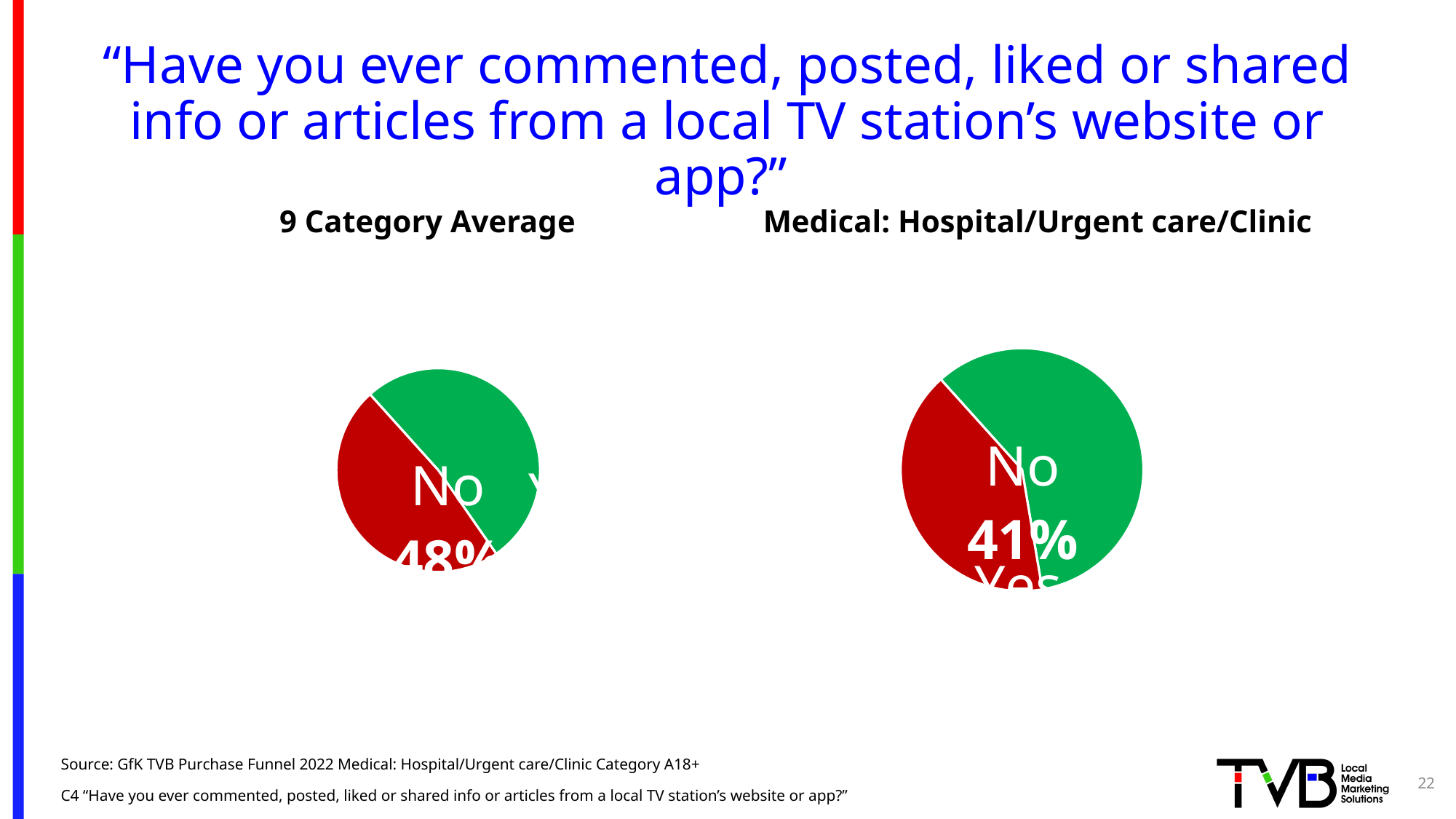
Which chart shows the larger No share, 9 Category Average or Medical: Hospital/Urgent care/Clinic? 9 Category Average In the Medical: Hospital/Urgent care/Clinic chart, which slice is larger, Yes or No? Yes What is the title of the pie chart on the right side of the slide? Medical: Hospital/Urgent care/Clinic In the 9 Category Average chart, what percentage answered No? 48% In the Medical: Hospital/Urgent care/Clinic chart, what percentage answered No? 41% How many percentage points higher is the No share in the 9 Category Average chart than in the Medical: Hospital/Urgent care/Clinic chart? 7 percentage points In the 9 Category Average chart, what colour is the No slice? Red How many pie charts are shown on the slide? 2 How many slices does the Medical: Hospital/Urgent care/Clinic pie chart have? 2 What kind of chart is used for the 9 Category Average? Pie chart